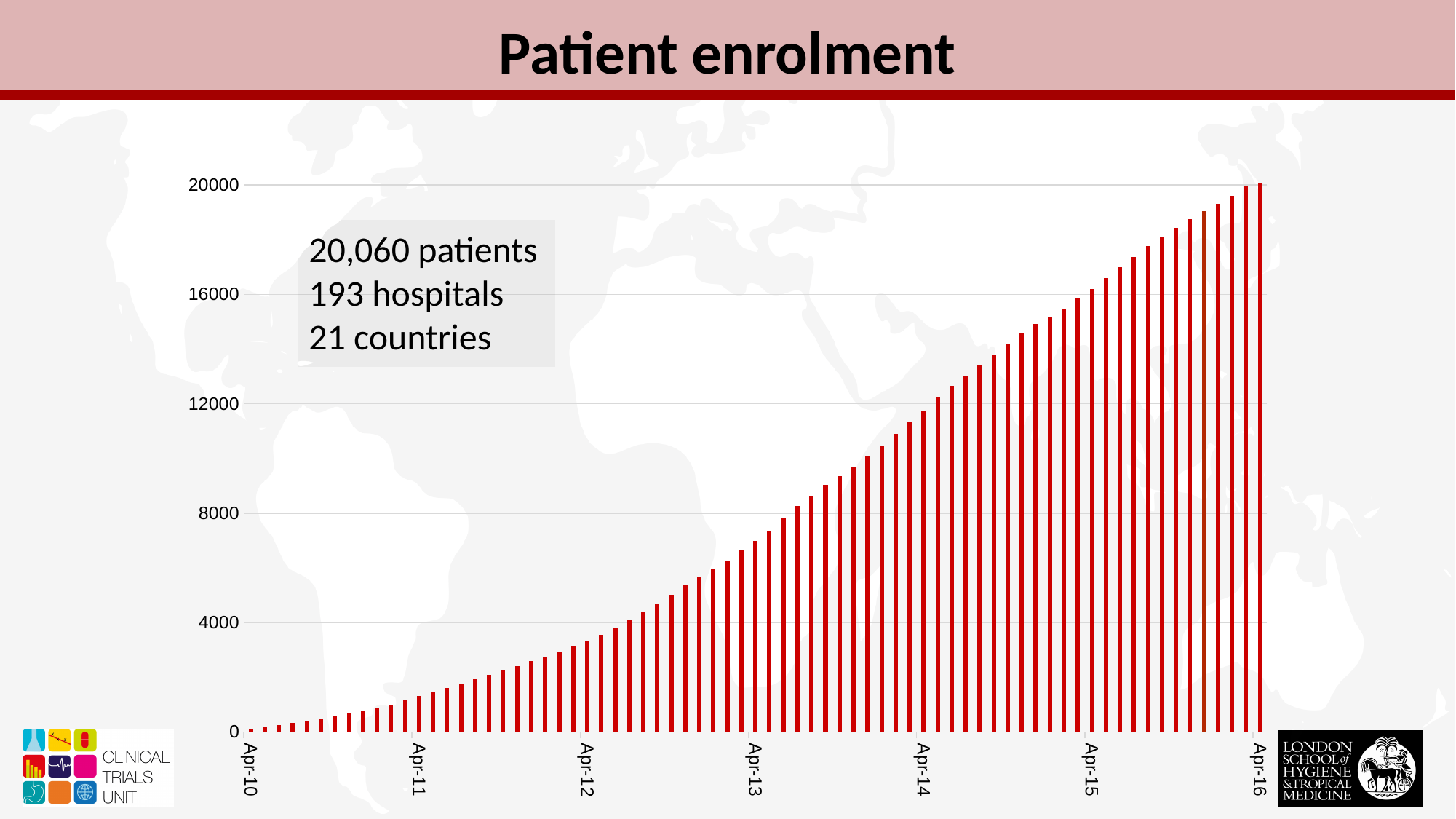
Is the value for Apr-15 greater or less than 12000? greater What colour are the bars in the chart? red Is the value for Apr-12 greater or less than 4000? less Is the value for Apr-13 greater or less than 8000? less What kind of chart is shown on the slide? bar chart Which labelled date on the x axis has the lowest bar? Apr-10 Do the bar values rise or fall from Apr-10 to Apr-16? rise What is the title of the slide containing the chart? Patient enrolment Which labelled date on the x axis has the highest bar? Apr-16 How many date labels are shown on the x axis? 7 Which is larger, the value for Apr-13 or the value for Apr-12? Apr-13